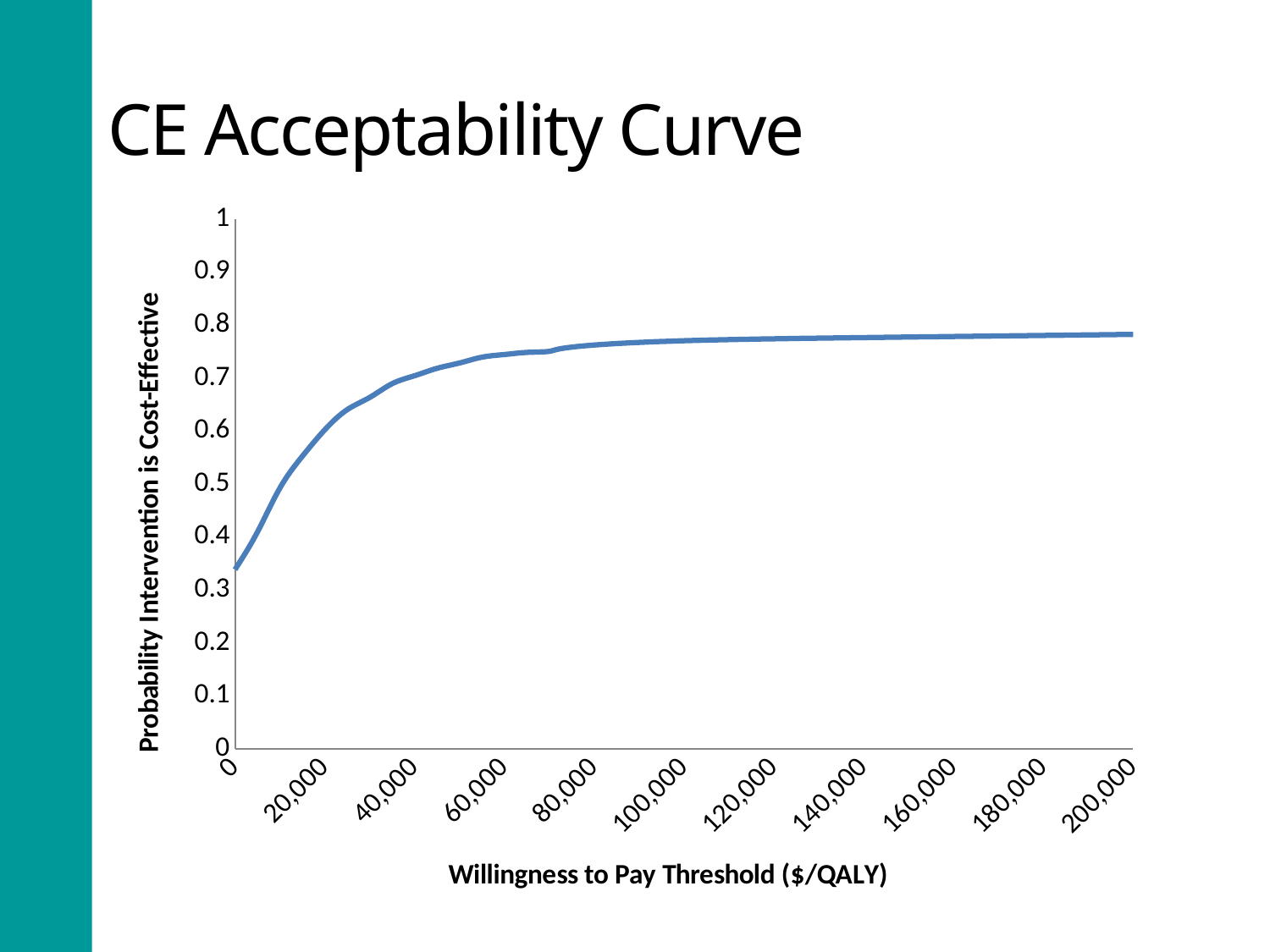
Which has the higher probability: a willingness to pay threshold of 20,000 or 60,000? 60,000 What is the label of the x axis? Willingness to Pay Threshold ($/QALY) At which willingness to pay threshold shown on the x axis is the probability lowest? 0 Is the probability at a willingness to pay threshold of 0 greater or less than 0.3? greater Does the probability rise or fall as the willingness to pay threshold increases? rise What is the title of the chart? CE Acceptability Curve What kind of chart is shown on the slide? line chart Is the probability at a willingness to pay threshold of 40,000 greater or less than 0.6? greater Is the probability at a willingness to pay threshold of 20,000 greater or less than 0.5? greater